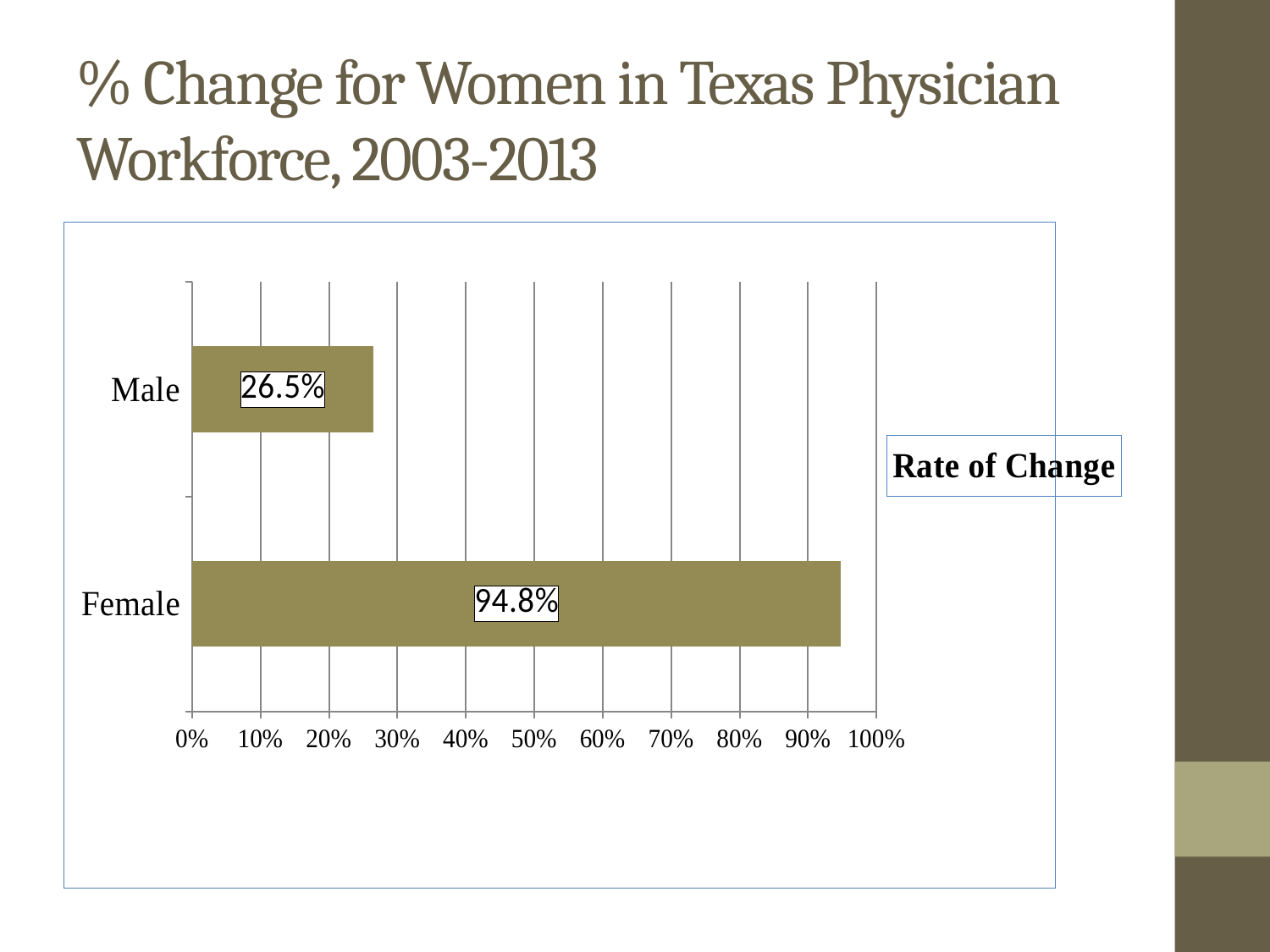
What kind of chart is shown on the slide? Bar chart Which category has the highest rate of change? Female Which is larger, the rate of change for Male or for Female? Female What is the legend entry shown for the chart? Rate of Change How many series does the legend list? 1 Is the value for Male greater or less than 30%? less Is the value for Female greater or less than 90%? greater Which category has the lowest rate of change? Male What is the rate of change for Male? 26.5% How many categories are shown in the chart? 2 What is the rate of change for Female? 94.8% What is the difference between the Female and Male rates of change? 68.3%